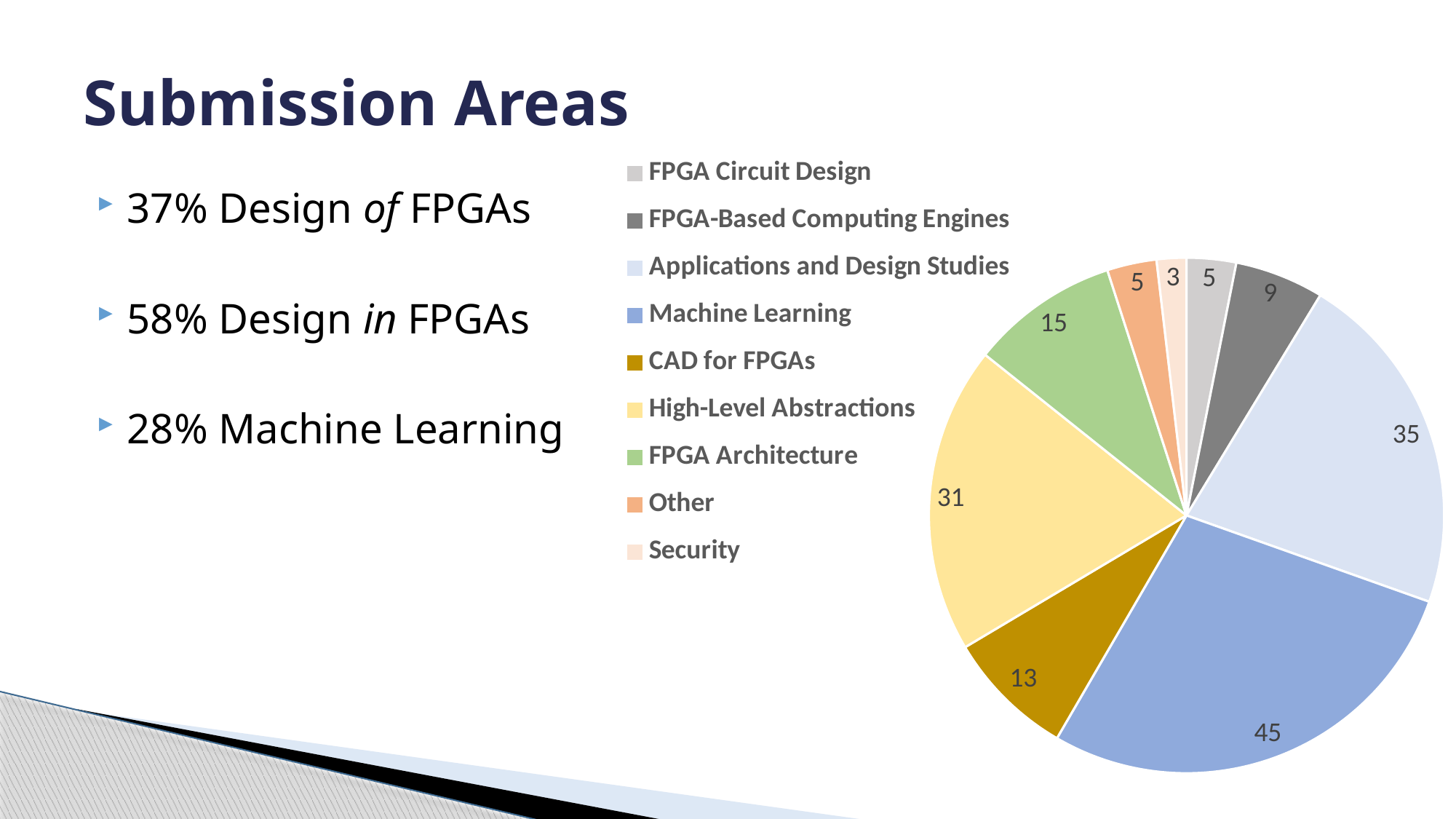
According to the slide, what share of submissions is Machine Learning? 28% What is the value for Security in the pie chart? 3 What kind of chart is shown on the slide? pie chart Which category has the smallest slice in the pie chart? Security How many slices does the pie chart have? 9 What is the value for Applications and Design Studies in the pie chart? 35 What is the value for High-Level Abstractions in the pie chart? 31 What is the value for CAD for FPGAs in the pie chart? 13 What is the difference between the values for Machine Learning and Applications and Design Studies? 10 Which is larger in the pie chart, FPGA Architecture or FPGA-Based Computing Engines? FPGA Architecture What is the value for Machine Learning in the pie chart? 45 Which category has the largest slice in the pie chart? Machine Learning